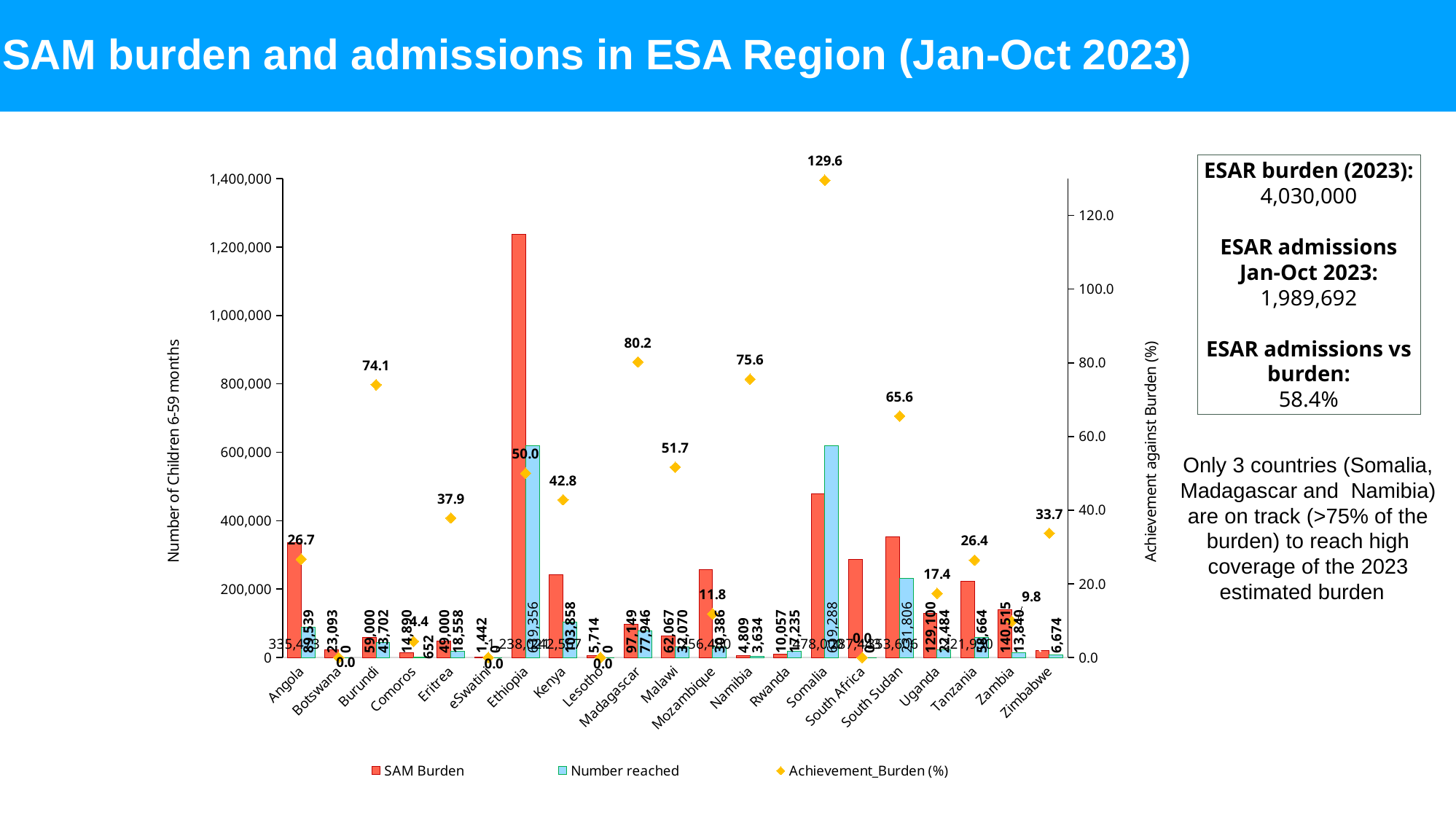
What is the SAM Burden for Eritrea? 49,000 Is the SAM Burden for Ethiopia greater or less than 1,200,000? greater What is the Number reached for Burundi? 43,702 What is the Achievement_Burden (%) value for Somalia? 129.6 Which country has the highest SAM Burden? Ethiopia How many series does the legend list? 3 How many countries are shown on the x axis? 21 Which has a higher Achievement_Burden (%), Kenya or Eritrea? Kenya What kind of chart is this? combination bar and line chart What is the Achievement_Burden (%) value for Burundi? 74.1 What is the difference between the Achievement_Burden (%) of Madagascar and Namibia? 4.6